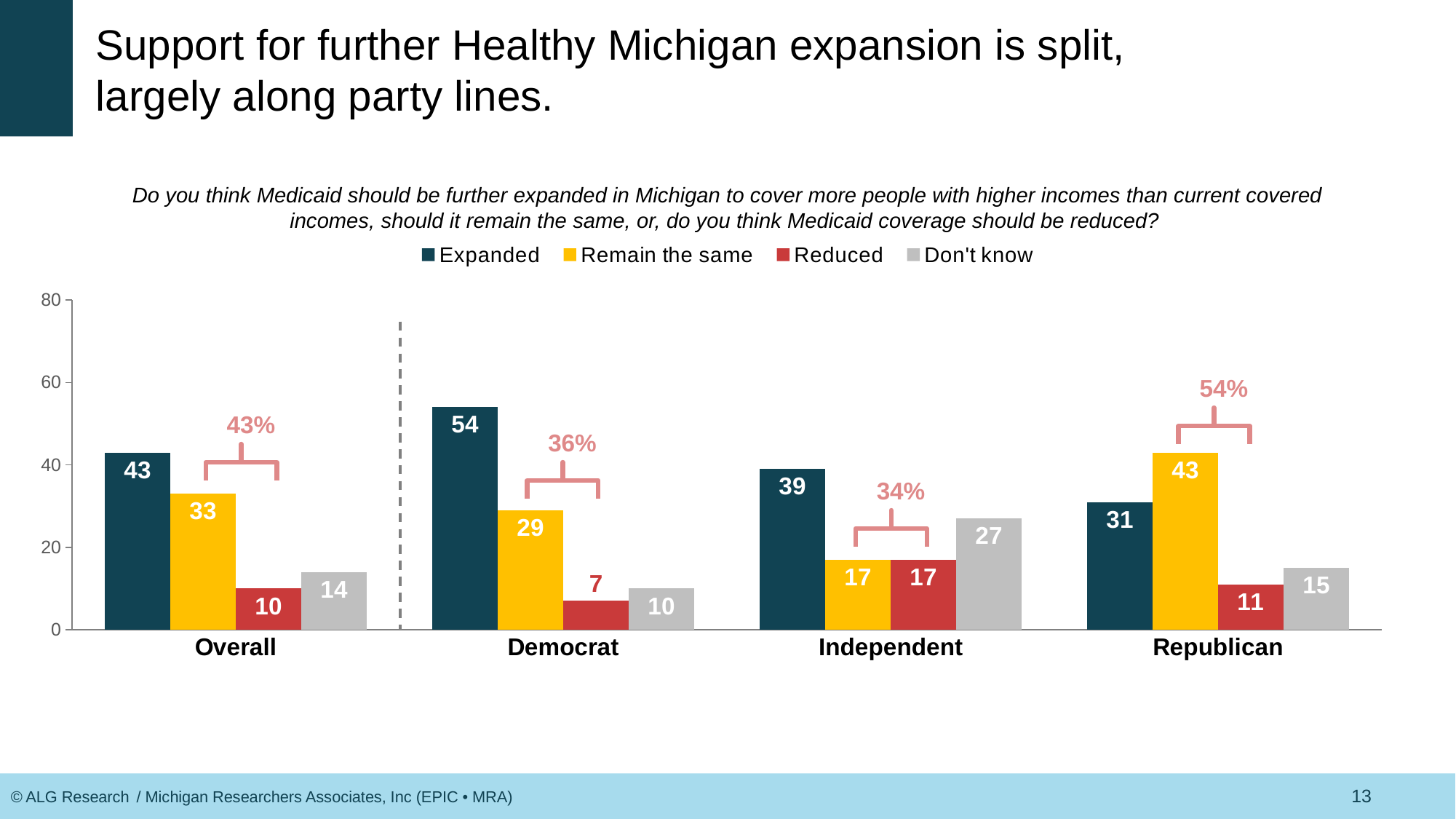
What is the value for Remain the same in the Republican group? 43 What is the value for Expanded in the Democrat group? 54 What kind of chart is shown on the slide? Bar chart What is the bracketed percentage shown above the Independent group? 34% What is the value for Don't know in the Independent group? 27 How many series does the legend list? 4 What is the difference between the Expanded values for Democrat and Republican? 23 How many groups are shown on the x axis? 4 What is the value for Reduced in the Overall group? 10 Which is larger in the Republican group, Expanded or Remain the same? Remain the same Which group has the lowest value for Reduced? Democrat Which group has the highest value for Expanded? Democrat